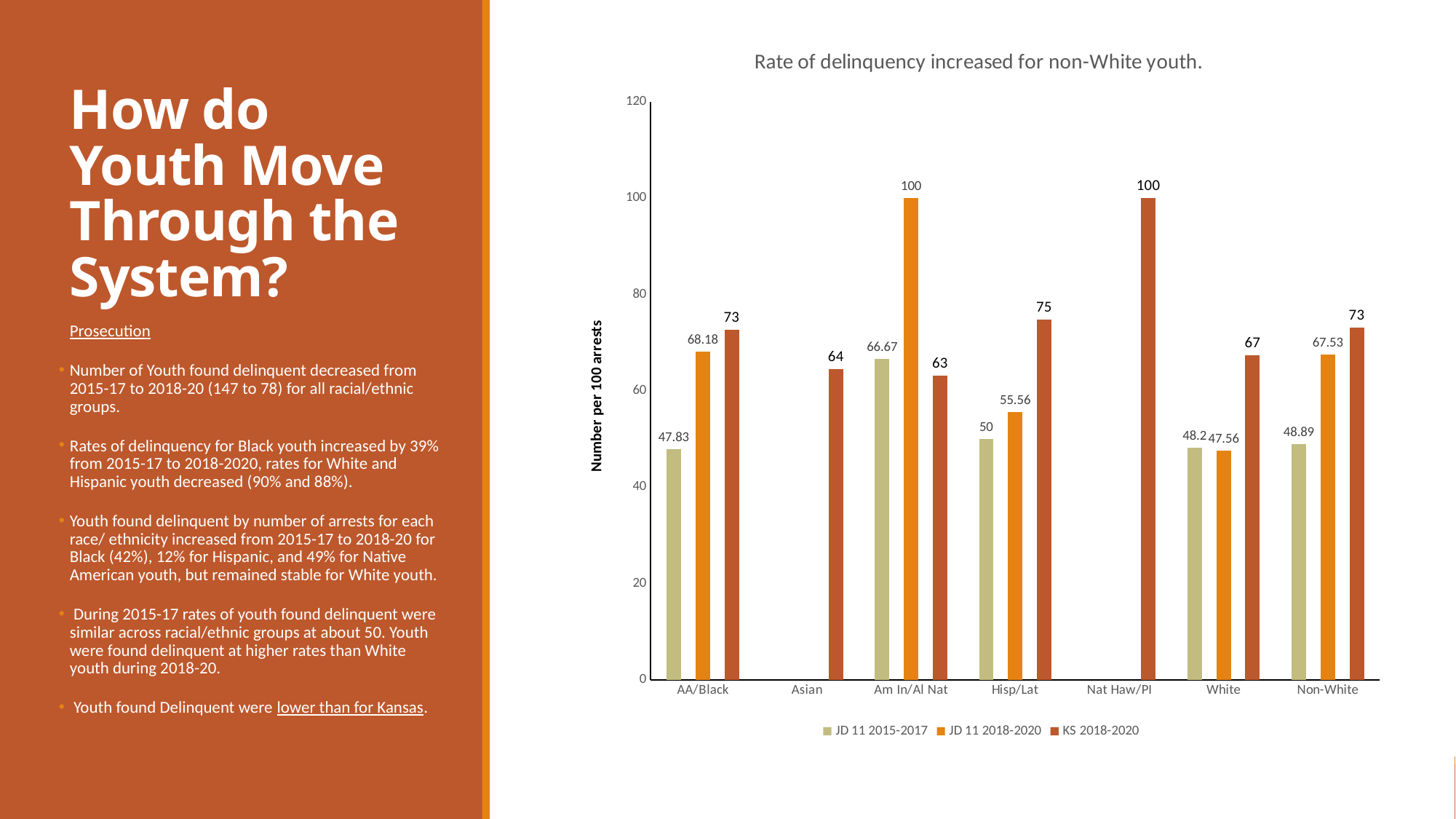
How many series does the legend list? 3 Which category has the lowest value in the KS 2018-2020 series? Am In/Al Nat Is the JD 11 2018-2020 value for Hisp/Lat greater or less than 60? less What is the JD 11 2015-2017 value for White? 48.2 What is the title of the chart? Rate of delinquency increased for non-White youth. Which category has the highest value in the JD 11 2018-2020 series? Am In/Al Nat How many categories are shown on the x axis? 7 What is the value for AA/Black in the JD 11 2018-2020 series? 68.18 What kind of chart is shown on the slide? bar chart Which is larger for Non-White: the JD 11 2018-2020 value or the KS 2018-2020 value? KS 2018-2020 What is the KS 2018-2020 value for Hisp/Lat? 75 What is the difference between the KS 2018-2020 value for Nat Haw/PI and the KS 2018-2020 value for Asian? 36